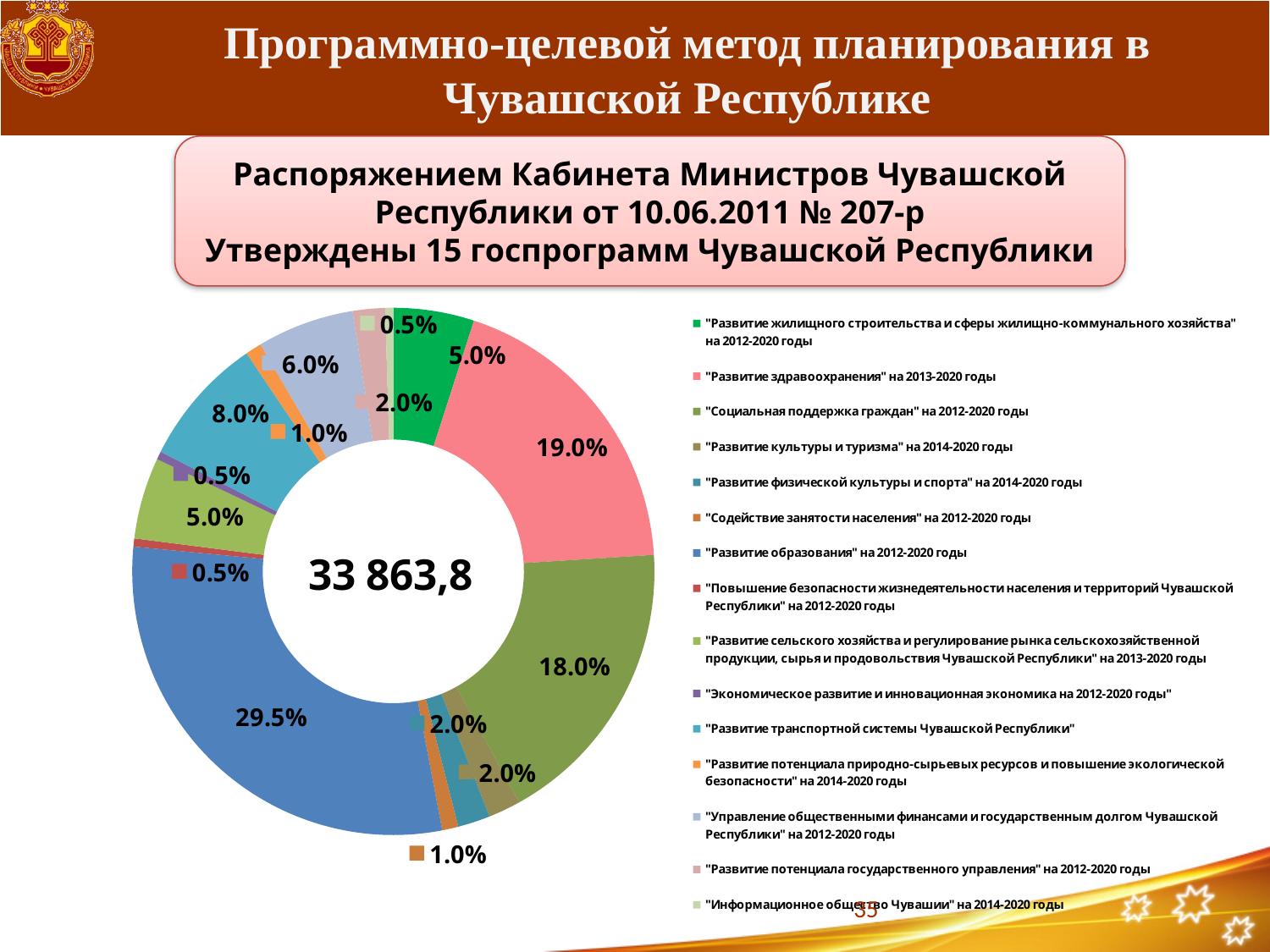
Which program has the largest share of the doughnut chart? "Развитие образования" на 2012-2020 годы What value is printed in the centre of the doughnut chart? 33 863,8 What is the share for "Развитие здравоохранения" на 2013-2020 годы? 19.0% Which has a larger share: "Развитие здравоохранения" or "Социальная поддержка граждан"? "Развитие здравоохранения" на 2013-2020 годы What kind of chart is shown on the slide? Doughnut (pie) chart What is the share for "Развитие транспортной системы Чувашской Республики"? 8.0% What is the share for "Социальная поддержка граждан" на 2012-2020 годы? 18.0% How many entries does the legend list? 15 What is the share for "Развитие образования" на 2012-2020 годы? 29.5% How many slices does the doughnut chart have? 15 What is the difference in share between "Развитие образования" and "Развитие здравоохранения"? 10.5% What is the share for "Управление общественными финансами и государственным долгом Чувашской Республики" на 2012-2020 годы? 6.0%